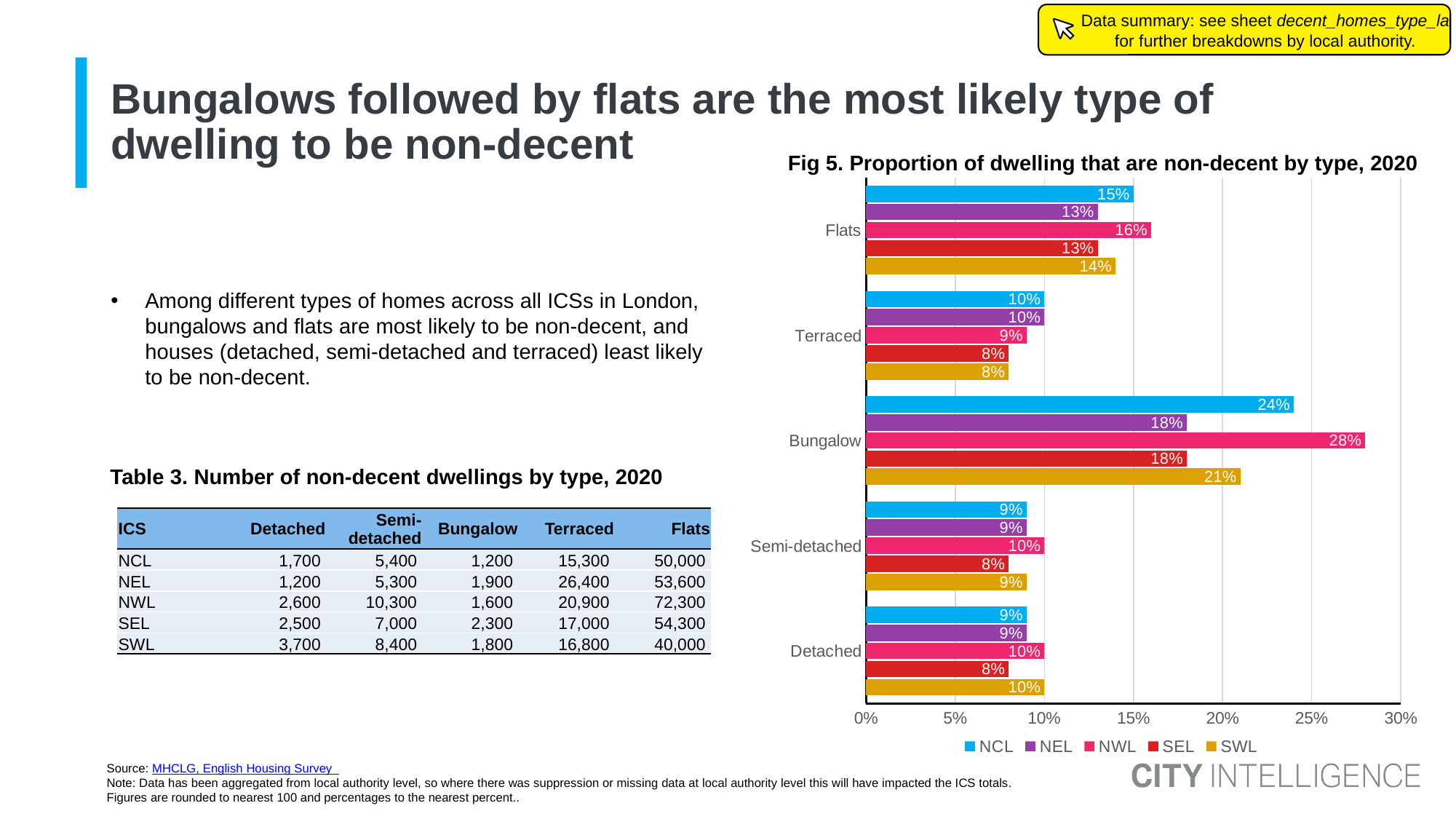
In Fig 5, which colour represents the SWL series? yellow/gold How many dwelling type categories are shown in Fig 5? 5 In Fig 5, what is the proportion of non-decent flats for NCL? 15% In Fig 5, which is larger: the NWL value for Flats or the SWL value for Flats? NWL In Fig 5, what is the value for SWL in the Bungalow category? 21% How many series does the legend of Fig 5 list? 5 In Fig 5, what is the difference between the NWL and NEL values for Bungalow? 10% In Fig 5, is the NCL value for Bungalow greater or less than 20%? greater In Fig 5, which ICS has the lowest proportion of non-decent terraced dwellings, SEL or NCL? SEL In Fig 5, which ICS has the highest proportion of non-decent bungalows? NWL In Fig 5, what is the proportion of non-decent bungalows for NWL? 28% What type of chart is Fig 5? bar chart